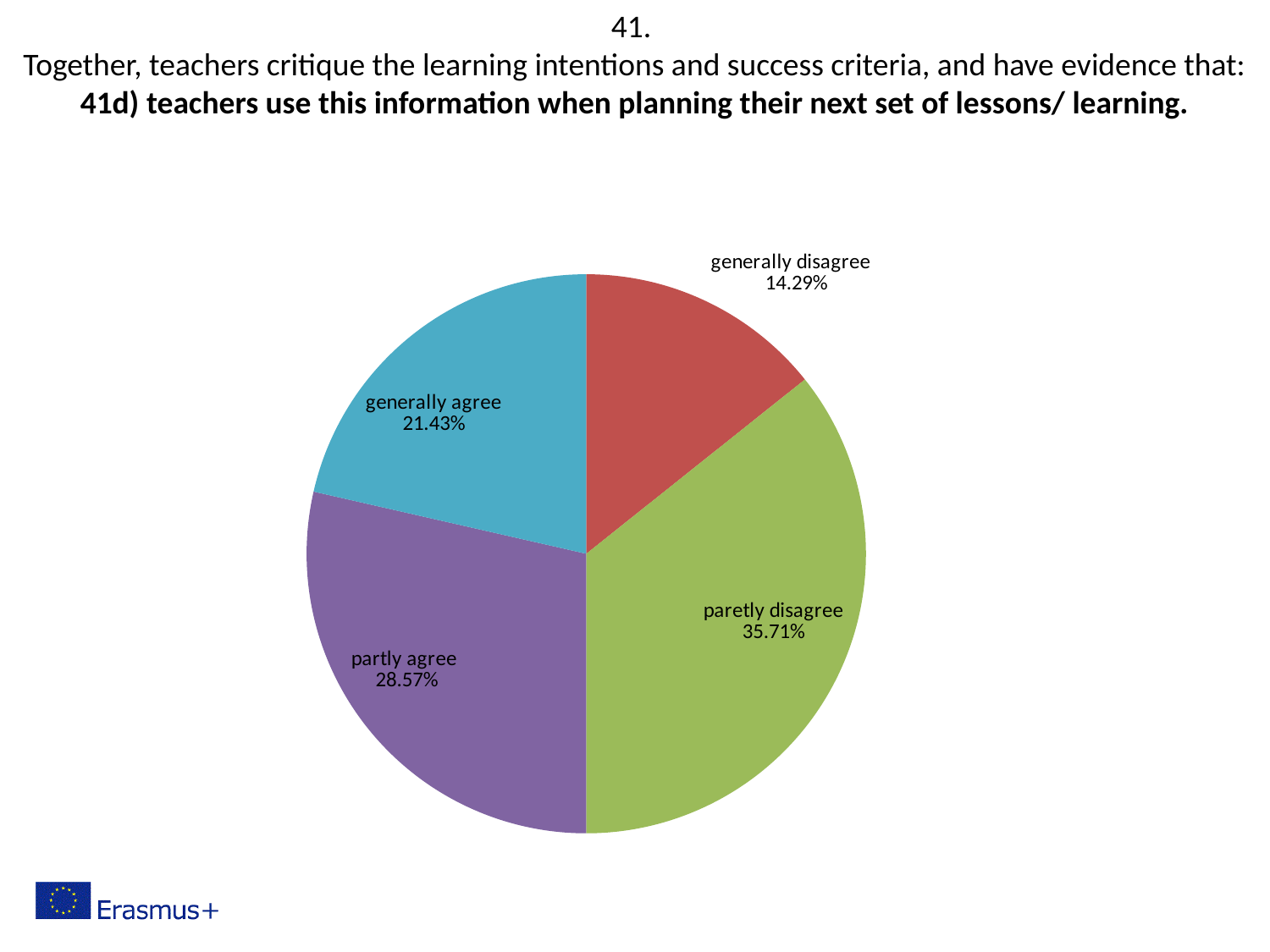
What share of the pie is labelled "paretly disagree"? 35.71% What share of the pie is labelled "generally disagree"? 14.29% What is the combined share of the "partly agree" and "generally agree" slices? 50% What share of the pie is labelled "partly agree"? 28.57% How many slices does the pie chart have? 4 Which slice of the pie is the smallest? generally disagree What is the difference in percentage points between the "paretly disagree" and "generally disagree" slices? 21.42 What colour is the "paretly disagree" slice? green Which is larger, the "partly agree" slice or the "generally agree" slice? partly agree What kind of chart is shown on the slide? pie chart Which slice of the pie is the largest? paretly disagree What share of the pie is labelled "generally agree"? 21.43%